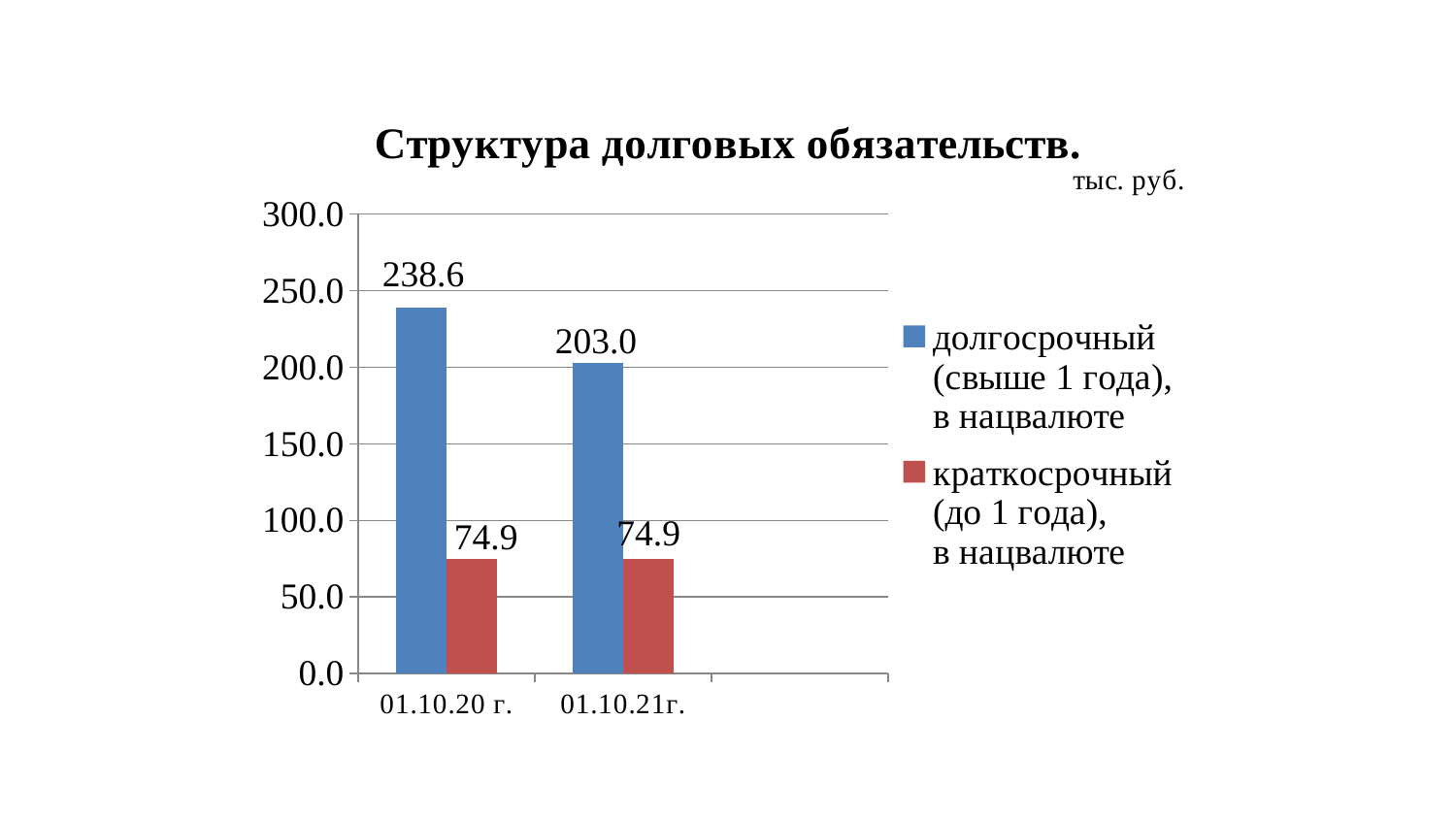
How many series does the legend list? 2 What is the value of the long-term (долгосрочный) series for 01.10.20 г.? 238.6 What is the value of the long-term (долгосрочный) series for 01.10.21г.? 203.0 What is the difference between the long-term values for 01.10.20 г. and 01.10.21г.? 35.6 What is the value of the short-term (краткосрочный) series for 01.10.20 г.? 74.9 Which is larger for 01.10.20 г.: the long-term or the short-term value? long-term (долгосрочный) What kind of chart is shown on the slide? bar chart Which category has the highest long-term (долгосрочный) value? 01.10.20 г. What is the difference between the long-term and short-term values for 01.10.21г.? 128.1 How many categories are shown on the x axis? 2 Is the long-term value for 01.10.21г. greater or less than 250.0? less What is the value of the short-term (краткосрочный) series for 01.10.21г.? 74.9